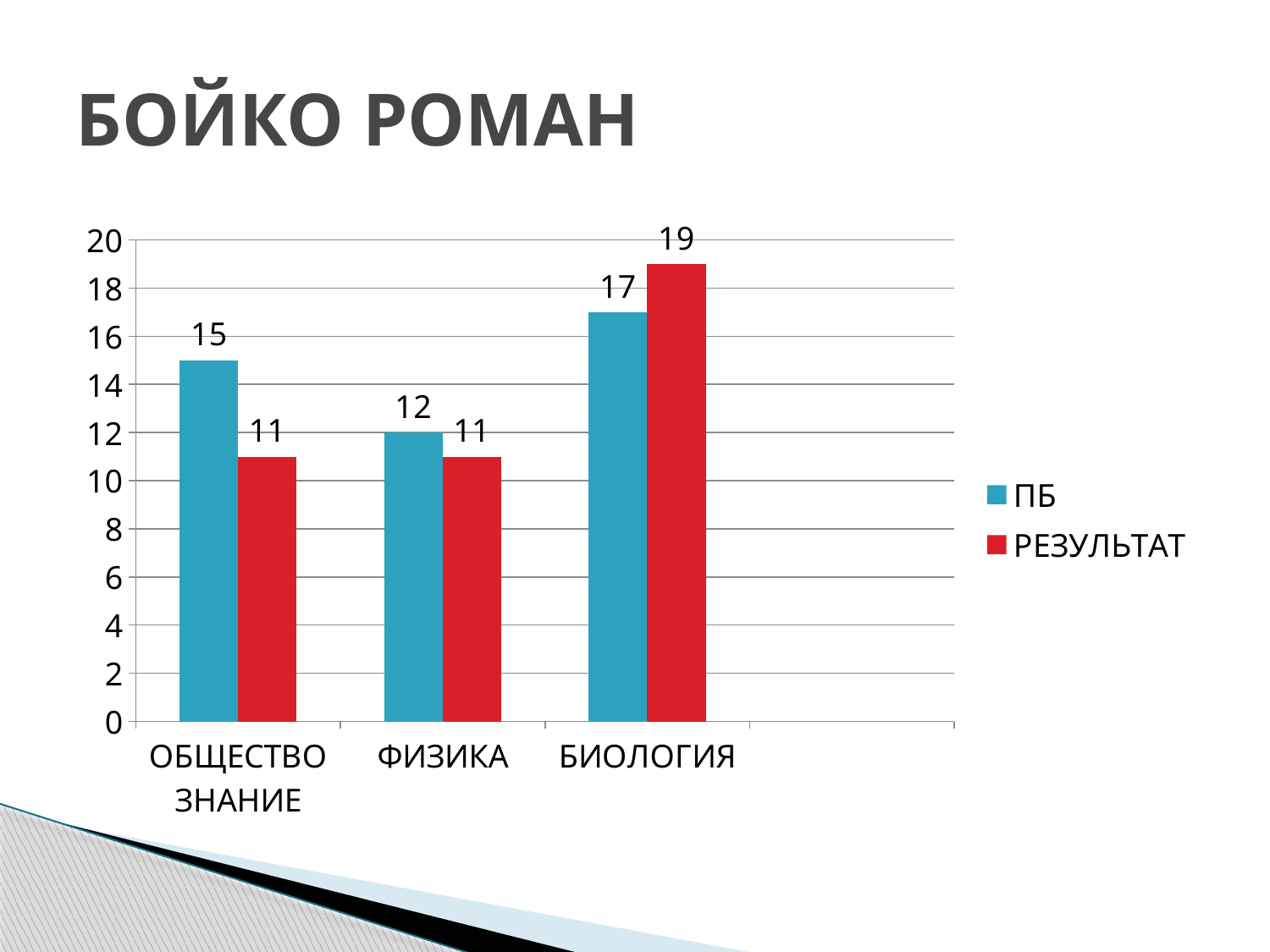
How many categories are shown on the x axis? 3 Which category has the lowest ПБ value? ФИЗИКА How many series does the legend list? 2 What kind of chart is shown on the slide? Bar chart What is the РЕЗУЛЬТАТ value for БИОЛОГИЯ? 19 What is the difference between the РЕЗУЛЬТАТ values for БИОЛОГИЯ and ФИЗИКА? 8 What colour are the РЕЗУЛЬТАТ bars? Red For БИОЛОГИЯ, which is larger: ПБ or РЕЗУЛЬТАТ? РЕЗУЛЬТАТ Which category has the highest ПБ value? БИОЛОГИЯ What is the РЕЗУЛЬТАТ value for ОБЩЕСТВОЗНАНИЕ? 11 What is the difference between the ПБ and РЕЗУЛЬТАТ values for ОБЩЕСТВОЗНАНИЕ? 4 What is the ПБ value for ФИЗИКА? 12